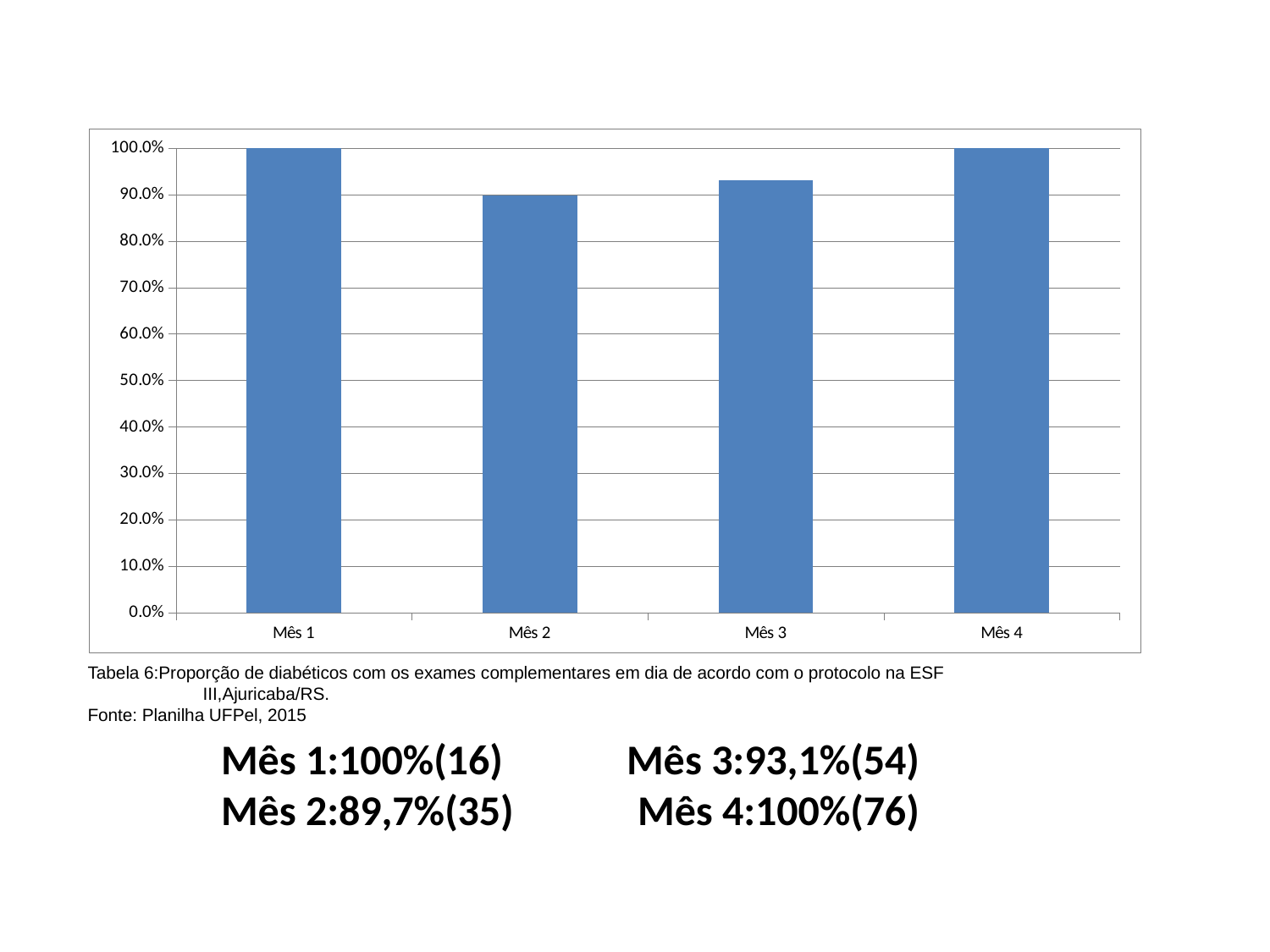
What is the difference between the values for Mês 3 and Mês 2? 3,4% Which month has the lowest value? Mês 2 How many months are shown on the x axis? 4 What is the difference between the values for Mês 1 and Mês 2? 10,3% Does the value rise or fall from Mês 1 to Mês 2? fall What is the value for Mês 3? 93,1% What kind of chart is shown on the slide? bar chart Is the value for Mês 3 greater or less than 90.0%? greater Which months share the highest value of 100%? Mês 1 and Mês 4 What is the value for Mês 4? 100% Which is larger, the value for Mês 2 or the value for Mês 3? Mês 3 What is the value for Mês 2? 89,7%